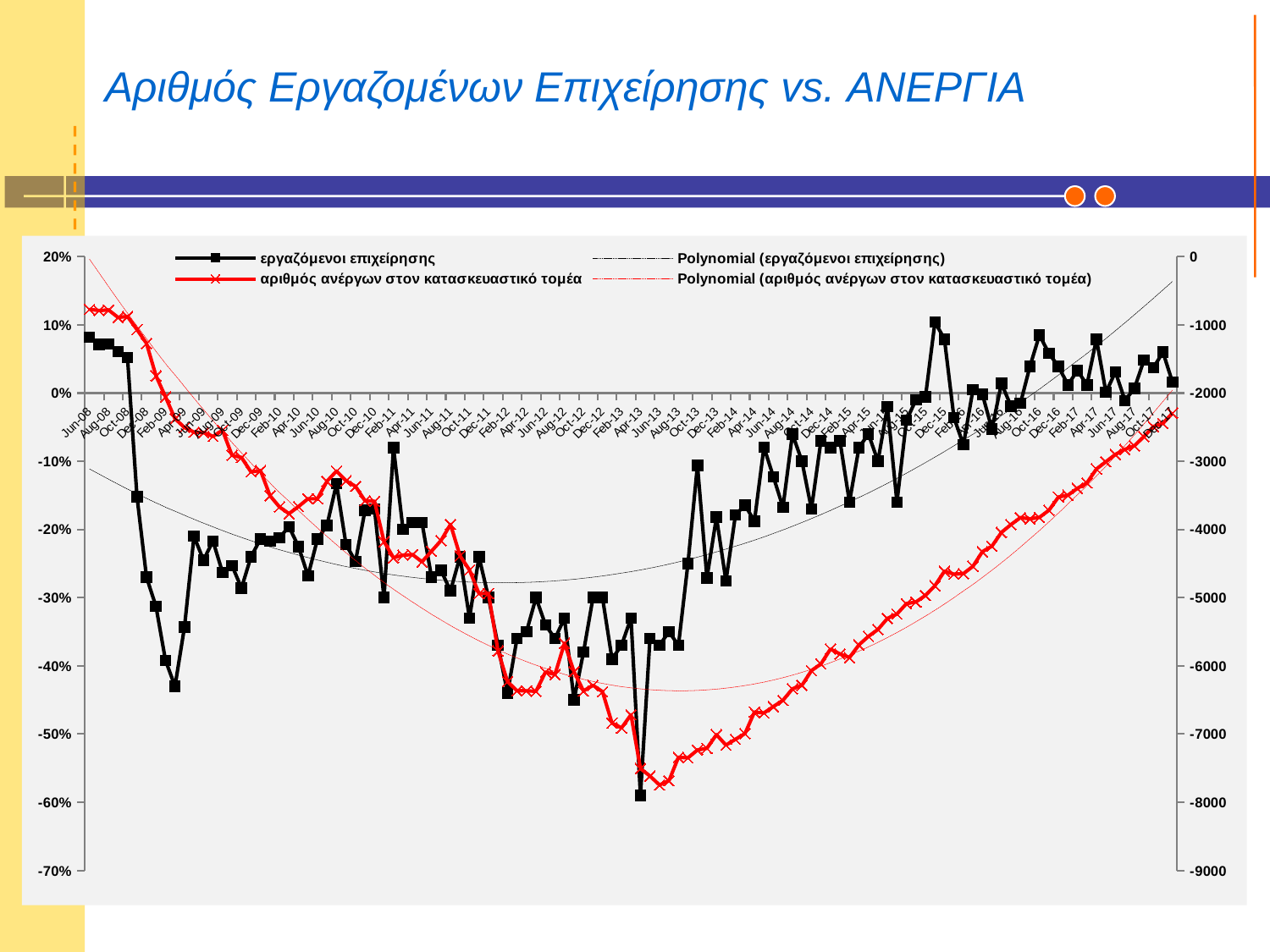
Is the value of 'εργαζόμενοι επιχείρησης' at Jun-08 greater or less than 0%? greater Which colour is used for the series 'αριθμός ανέργων στον κατασκευαστικό τομέα'? red Around which month does the 'εργαζόμενοι επιχείρησης' series reach its lowest point? Apr-13 Does the 'αριθμός ανέργων στον κατασκευαστικό τομέα' series generally rise or fall between Jun-13 and Dec-17? rise What is the title of the slide containing the chart? Αριθμός Εργαζομένων Επιχείρησης vs. ΑΝΕΡΓΙΑ Is the value of 'εργαζόμενοι επιχείρησης' at Jun-13 greater or less than -50%? greater Does the 'εργαζόμενοι επιχείρησης' series generally rise or fall between Jun-08 and Jun-13? fall What kind of chart is shown on the slide? line chart How many entries does the chart legend list? 4 Is the value of 'εργαζόμενοι επιχείρησης' at Oct-13 greater or less than -20%? greater